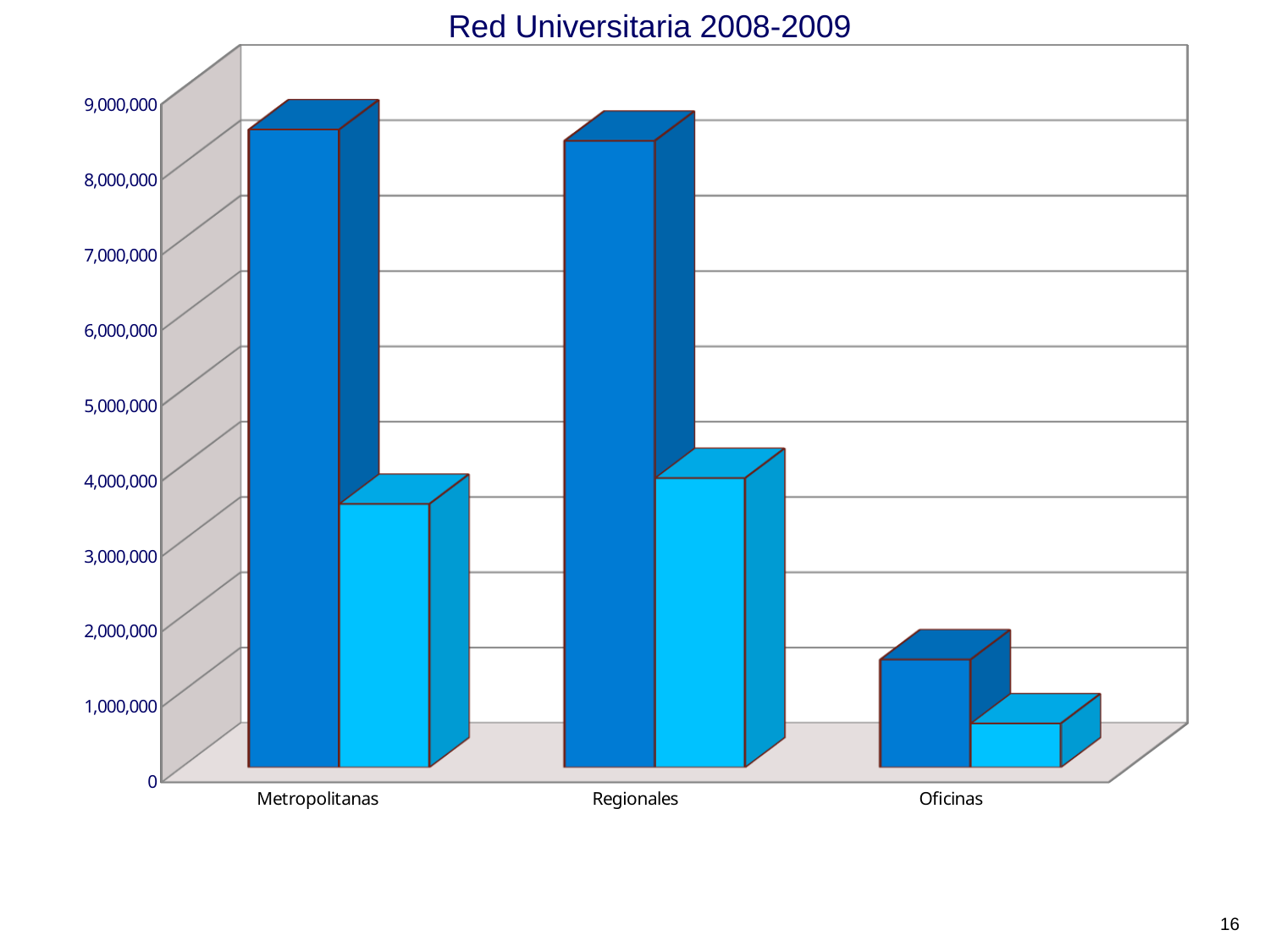
Is the light blue bar for Metropolitanas greater or less than 4,000,000? less Is the dark blue bar for Regionales greater or less than 8,000,000? greater Is the light blue bar for Oficinas greater or less than 1,000,000? less How many categories are shown on the x axis? 3 What is the highest value labelled on the vertical axis? 9,000,000 What is the title of the chart? Red Universitaria 2008-2009 How many bars are plotted for each category? 2 Which is larger: the dark blue bar for Regionales or the dark blue bar for Oficinas? Regionales What kind of chart is shown on the slide? bar chart Which category has the lowest values? Oficinas